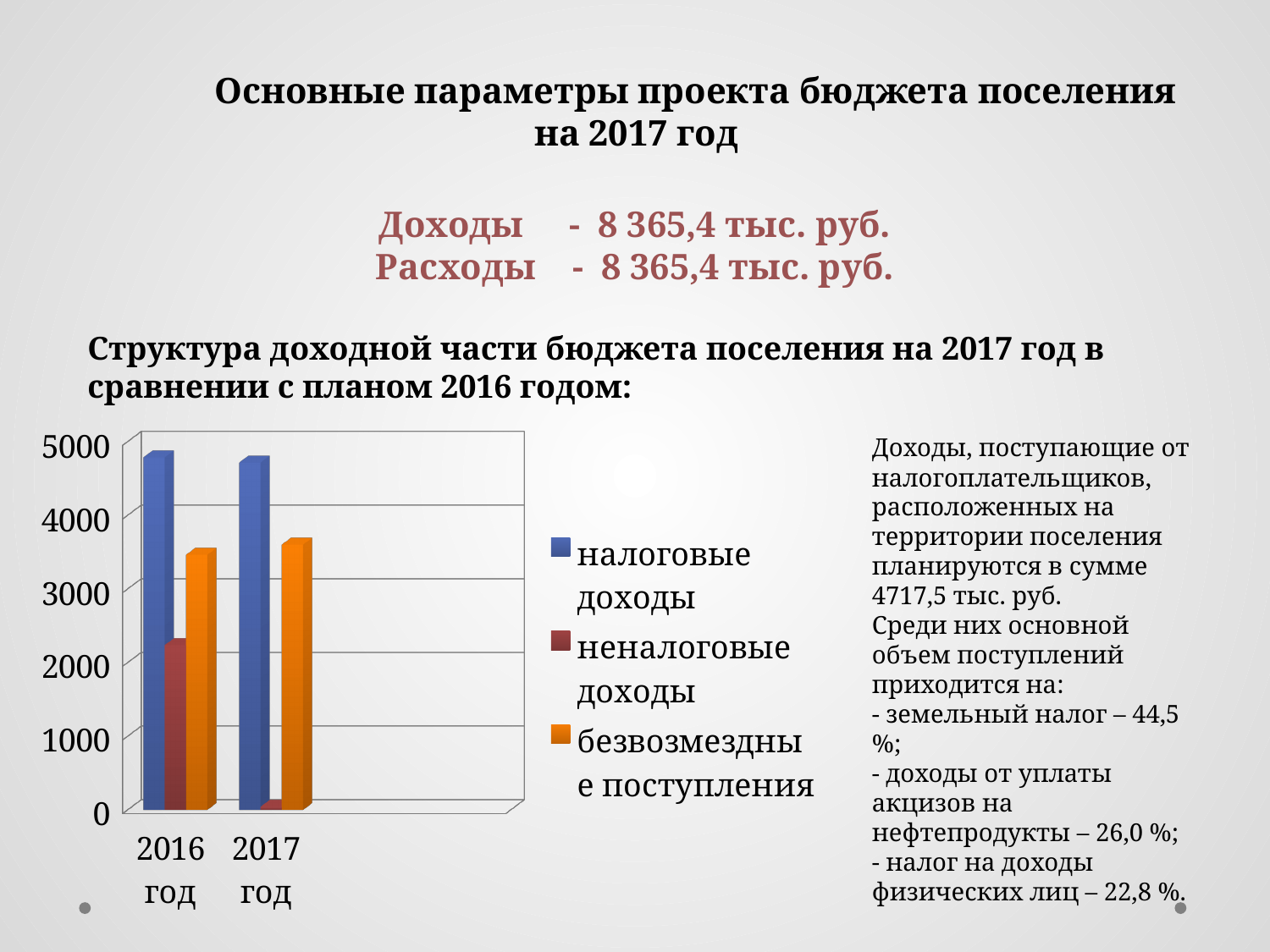
Do the values of неналоговые доходы rise or fall from 2016 год to 2017 год? fall What kind of chart is shown on the slide? bar chart Is the value of неналоговые доходы for 2016 год greater or less than 3000? less Which series has the lowest value for 2017 год? неналоговые доходы Is the value of неналоговые доходы for 2017 год greater or less than 1000? less Which series has the highest value for 2017 год? налоговые доходы How many series does the chart legend list? 3 Is the value of налоговые доходы for 2016 год greater or less than 4000? greater Which colour represents безвозмездные поступления in the chart legend? orange Which is larger for 2016 год: налоговые доходы or безвозмездные поступления? налоговые доходы How many categories (years) are shown on the x axis of the chart? 2